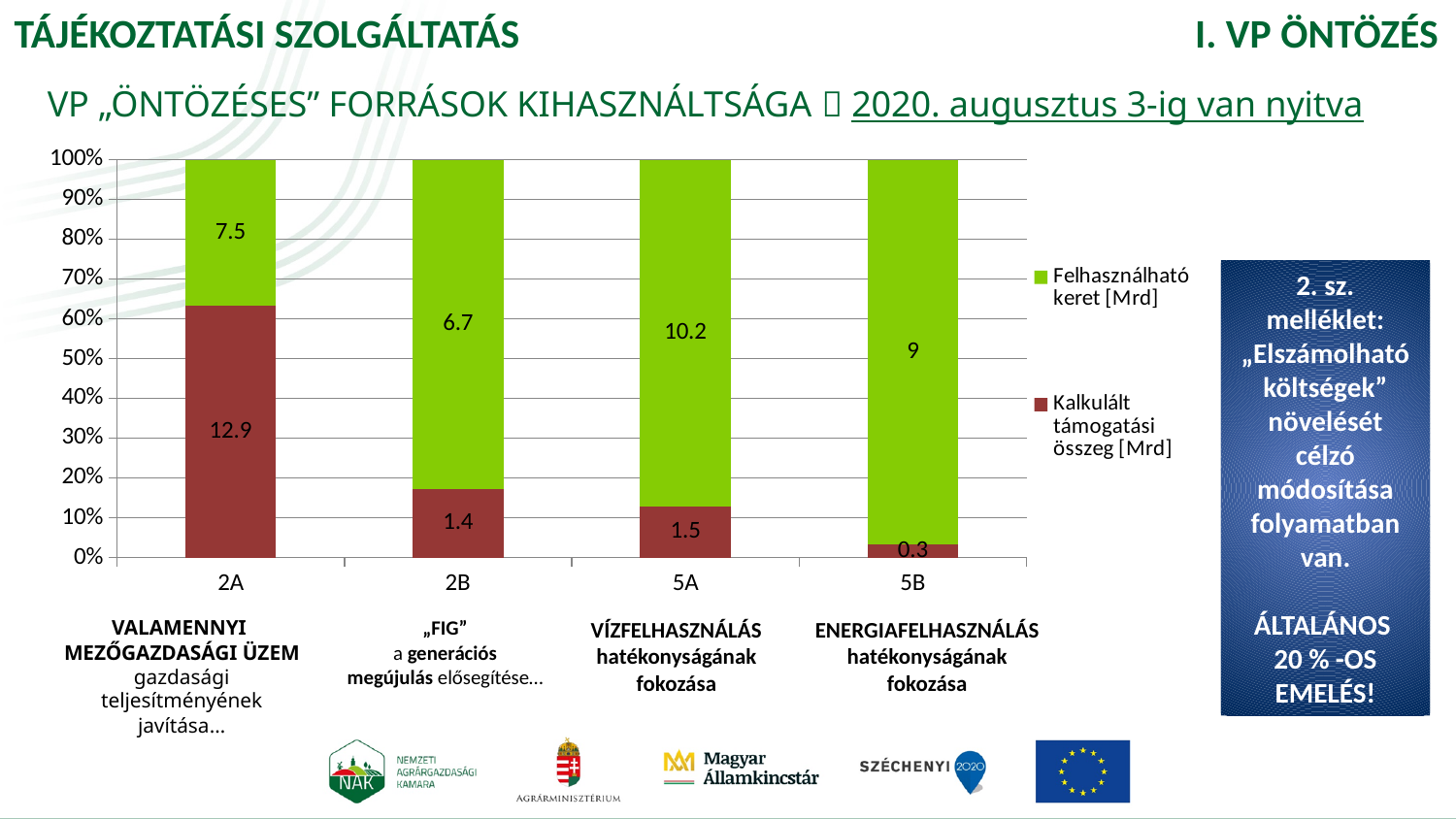
What is the Felhasználható keret [Mrd] value for category 2B? 6.7 What is the Felhasználható keret [Mrd] value for category 5A? 10.2 What is the Kalkulált támogatási összeg [Mrd] value for category 2A? 12.9 What is the difference between the Felhasználható keret [Mrd] values for 5A and 5B? 1.2 How many categories are shown on the x axis of the chart? 4 Which category has the highest Kalkulált támogatási összeg [Mrd] value? 2A Is the Kalkulált támogatási összeg share of the 2A bar greater or less than 50%? greater What is the Kalkulált támogatási összeg [Mrd] value for category 5B? 0.3 Which category has the lowest Felhasználható keret [Mrd] value? 2B How many series does the chart legend list? 2 Which is larger: the Kalkulált támogatási összeg [Mrd] value for 2B or for 5A? 5A What kind of chart is shown on the slide? Stacked bar chart